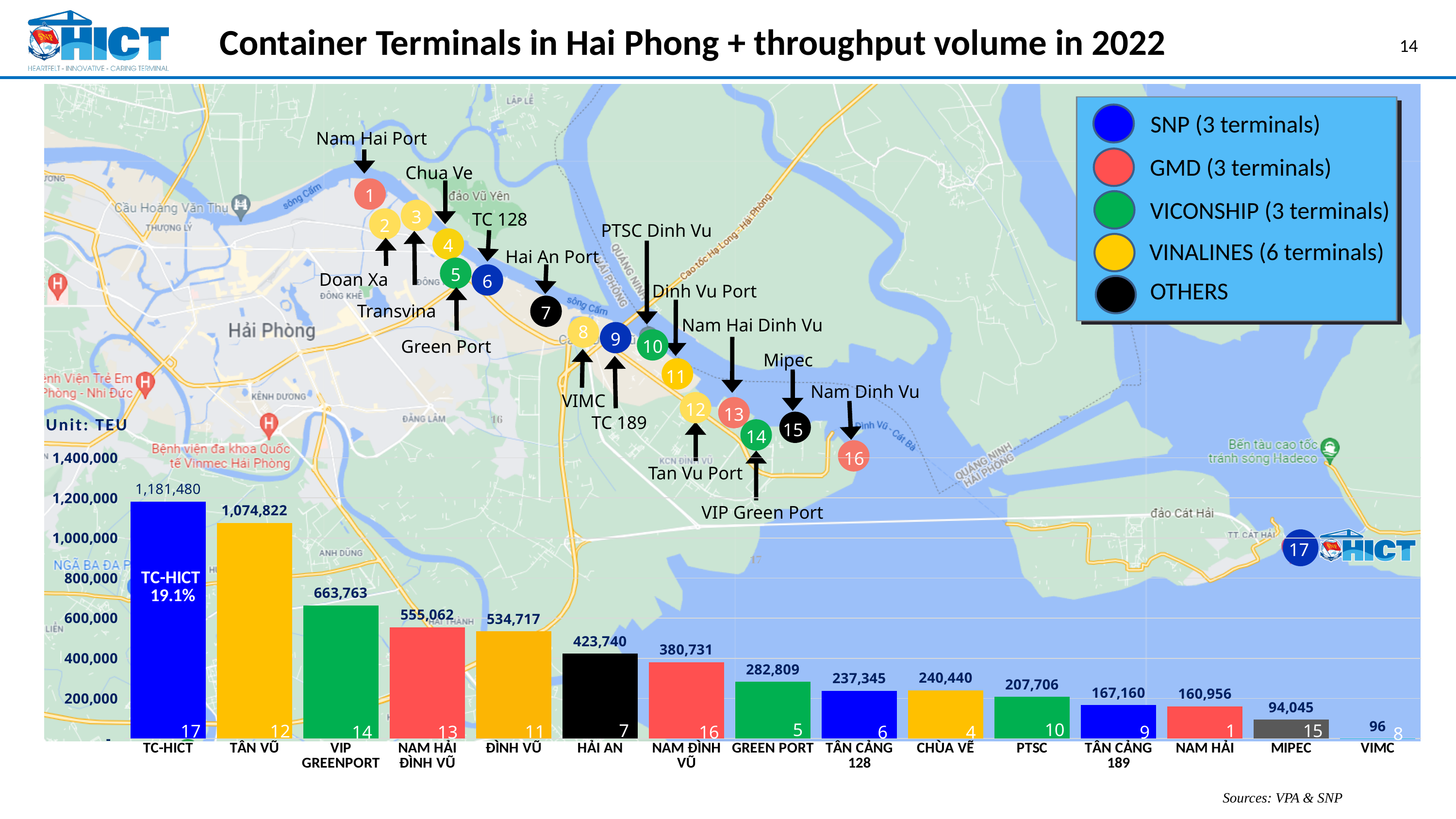
Which terminal has the highest throughput volume? TC-HICT Which has a larger throughput volume, VIP GREENPORT or NAM HẢI ĐÌNH VŨ? VIP GREENPORT What unit is used for the throughput values in the chart? TEU What type of chart is used to show the throughput volumes? bar chart What is the throughput volume for MIPEC? 94,045 What is the throughput volume for TÂN VŨ? 1,074,822 What is the throughput volume for HẢI AN? 423,740 Which terminal has the lowest throughput volume? VIMC What is the difference in throughput between TC-HICT and TÂN VŨ? 106,658 Is the throughput volume for GREEN PORT greater or less than 400,000? less What is the throughput volume for TC-HICT? 1,181,480 How many terminals are shown as bars in the chart? 15